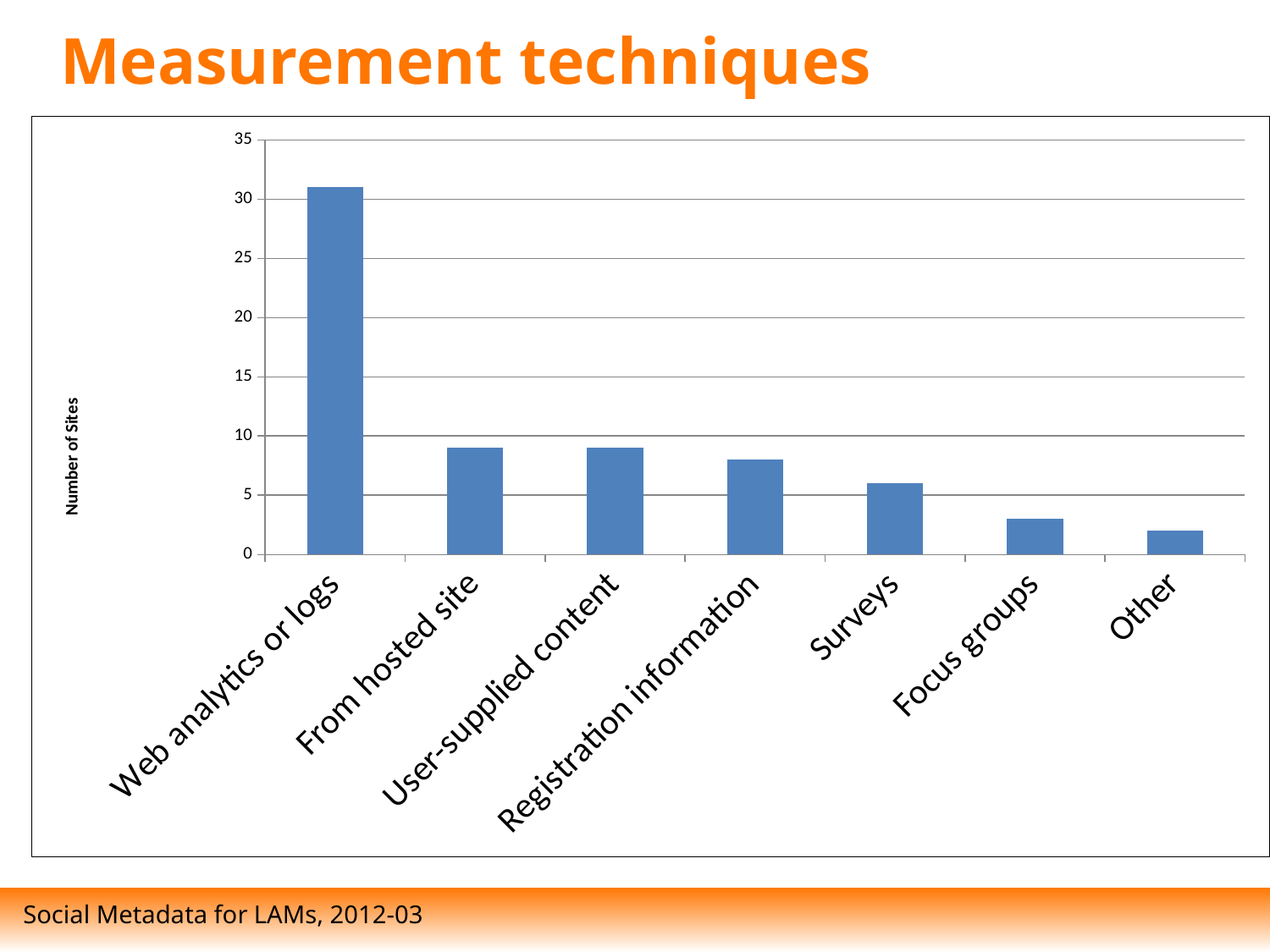
Is the value for Focus groups greater or less than 5? less How many categories are shown on the x axis of the chart? 7 Is the value for Surveys greater or less than 5? greater Is the value for Web analytics or logs greater or less than 30? greater Which has more sites, Web analytics or logs or Surveys? Web analytics or logs Do the values generally rise or fall moving from left to right along the x axis? fall Which has more sites, Registration information or Focus groups? Registration information What kind of chart is shown on the slide? bar chart What is the label on the vertical axis of the chart? Number of Sites Which measurement technique has the lowest number of sites? Other Which measurement technique has the highest number of sites? Web analytics or logs